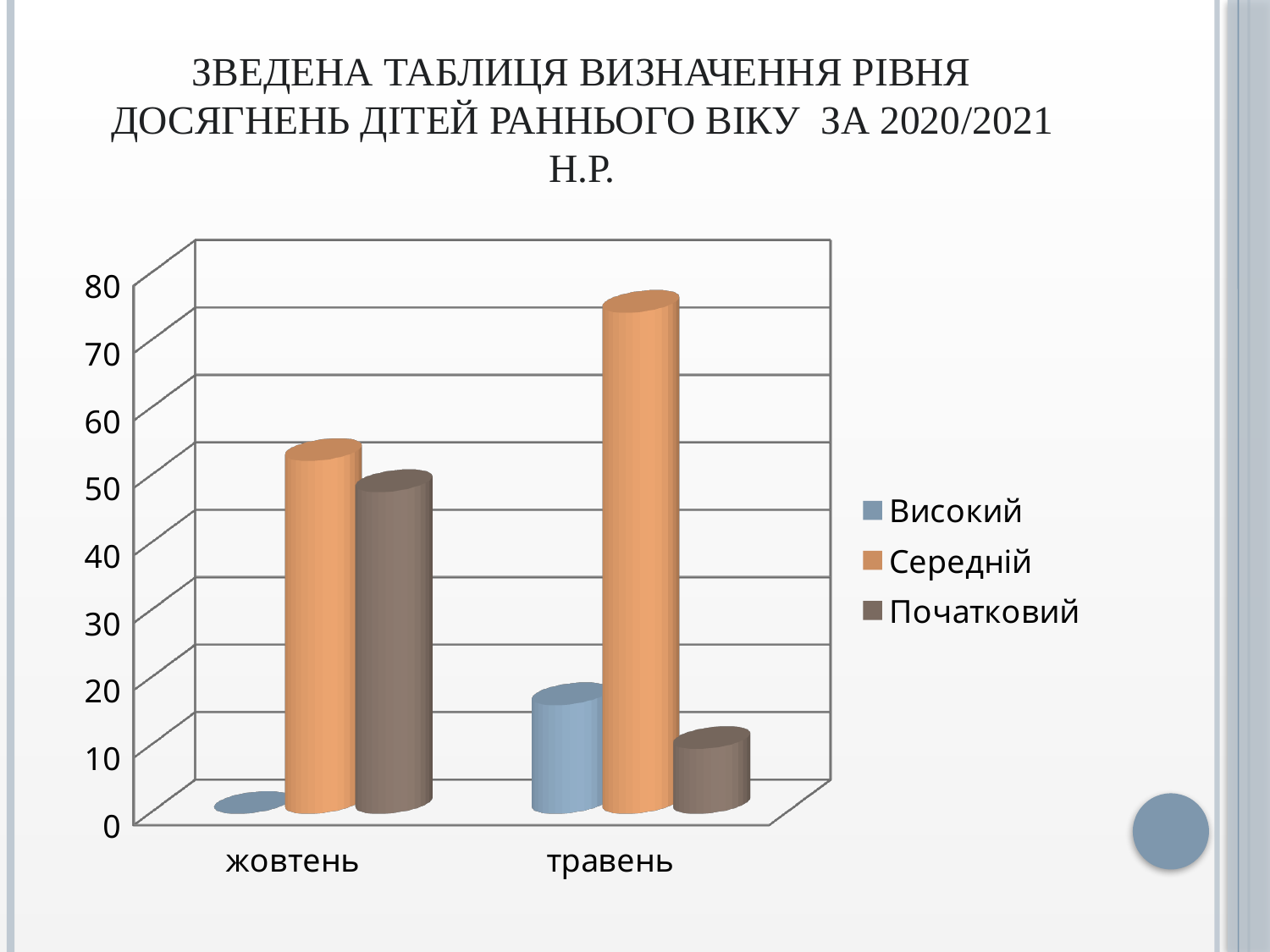
What kind of chart is shown on the slide? bar chart How many categories are shown on the x axis? 2 Which series has the lowest value for жовтень? Високий For жовтень, which is larger: Середній or Початковий? Середній Which series has the lowest value for травень? Початковий Which series has the highest value for травень? Середній Is the value for Початковий in жовтень greater or less than 40? greater Which legend entry is shown in orange? Середній How many series does the legend list? 3 Does the value for Середній rise or fall from жовтень to травень? rise Is the value for Високий in травень greater or less than 20? less Is the value for Середній in травень greater or less than 70? greater